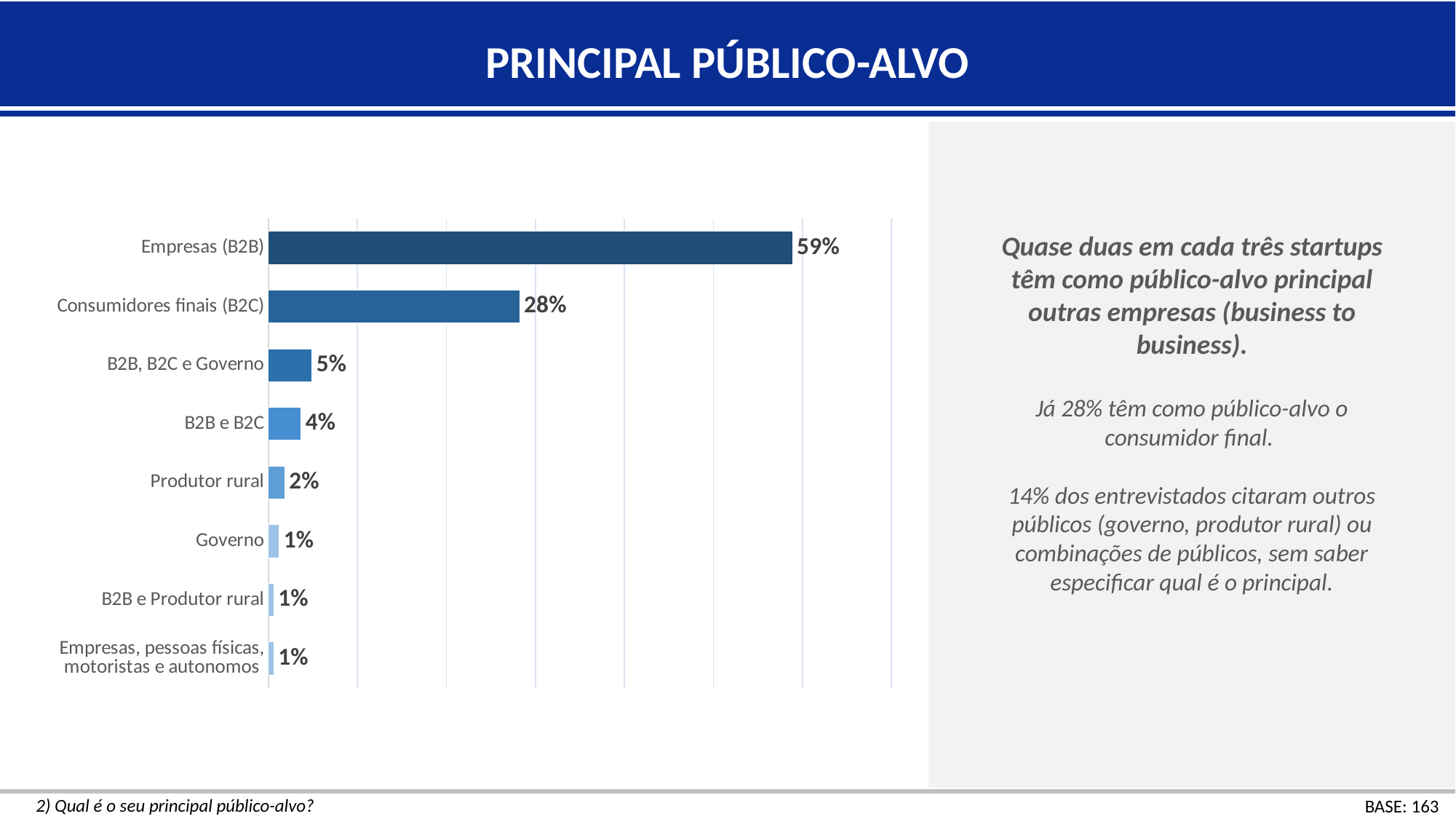
What is the difference between the values for B2B, B2C e Governo and B2B e B2C? 1% What is the difference between the values for Empresas (B2B) and Consumidores finais (B2C)? 31% What is the value for Produtor rural? 2% How many categories have a value of 1%? 3 Which is larger, the value for B2B e B2C or the value for Produtor rural? B2B e B2C What kind of chart is shown on the slide? Bar chart What is the value for B2B, B2C e Governo? 5% What is the value for Consumidores finais (B2C)? 28% What is the value for Empresas (B2B)? 59% What is the title of the slide containing the chart? PRINCIPAL PÚBLICO-ALVO Which category has the highest value? Empresas (B2B) How many categories are shown in the chart? 8